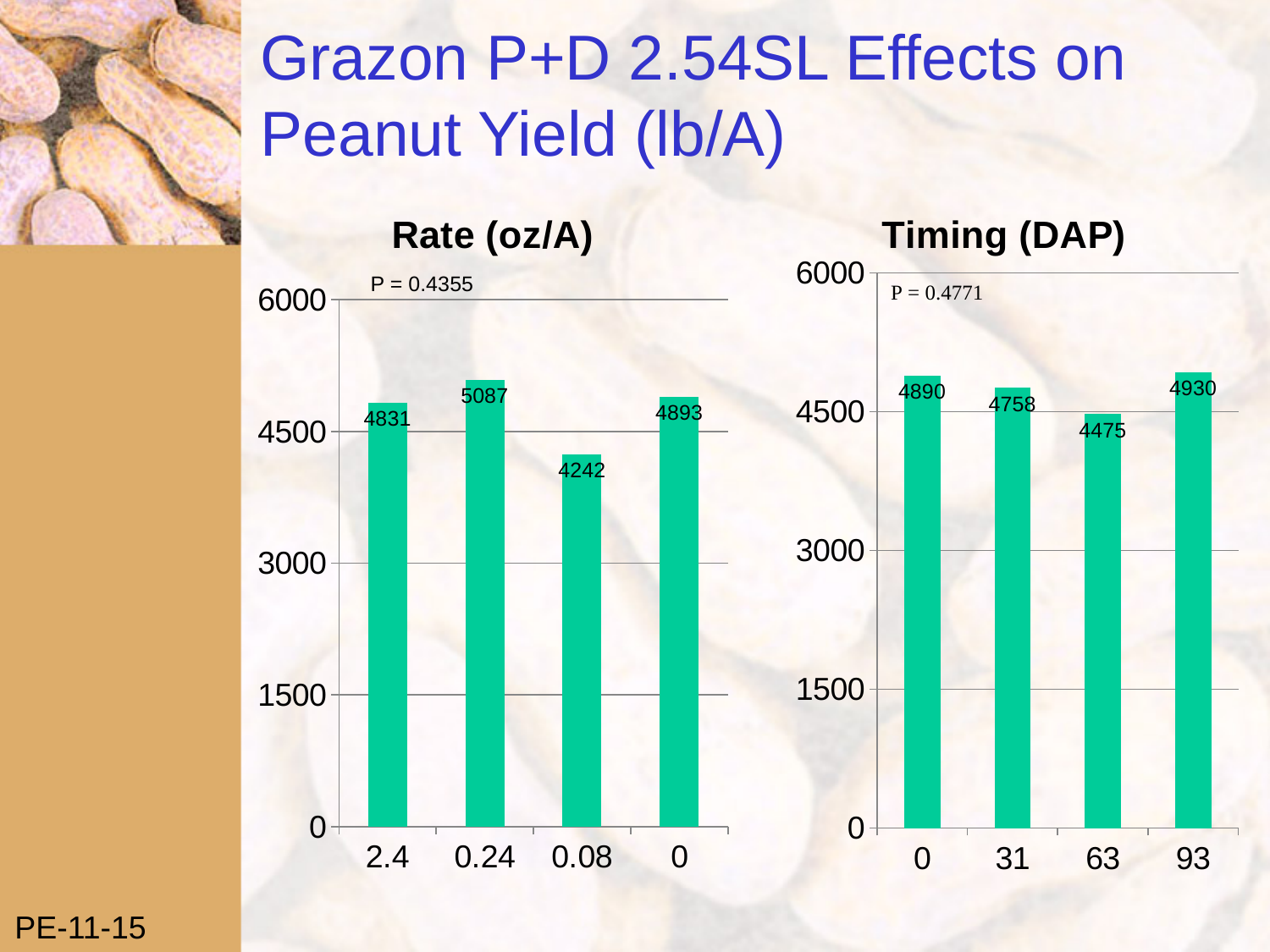
In the Timing (DAP) chart, which timing has the highest yield? 93 In the Timing (DAP) chart, what is the difference between the yields at 93 DAP and 63 DAP? 455 In the Rate (oz/A) chart, which rate has the highest yield? 0.24 In the Rate (oz/A) chart, which rate has the lowest yield? 0.08 What kind of chart is the Rate (oz/A) chart? Bar chart In the Timing (DAP) chart, what is the yield at 63 DAP? 4475 In the Timing (DAP) chart, which timing has the lowest yield? 63 In the Rate (oz/A) chart, how many rate categories are shown? 4 In the Timing (DAP) chart, is the yield at 0 DAP or at 31 DAP larger? 0 DAP In the Rate (oz/A) chart, what is the difference between the yields for the 0.24 and 0.08 rates? 845 What P value is shown on the Timing (DAP) chart? P = 0.4771 In the Rate (oz/A) chart, what is the peanut yield for the 0.24 rate? 5087